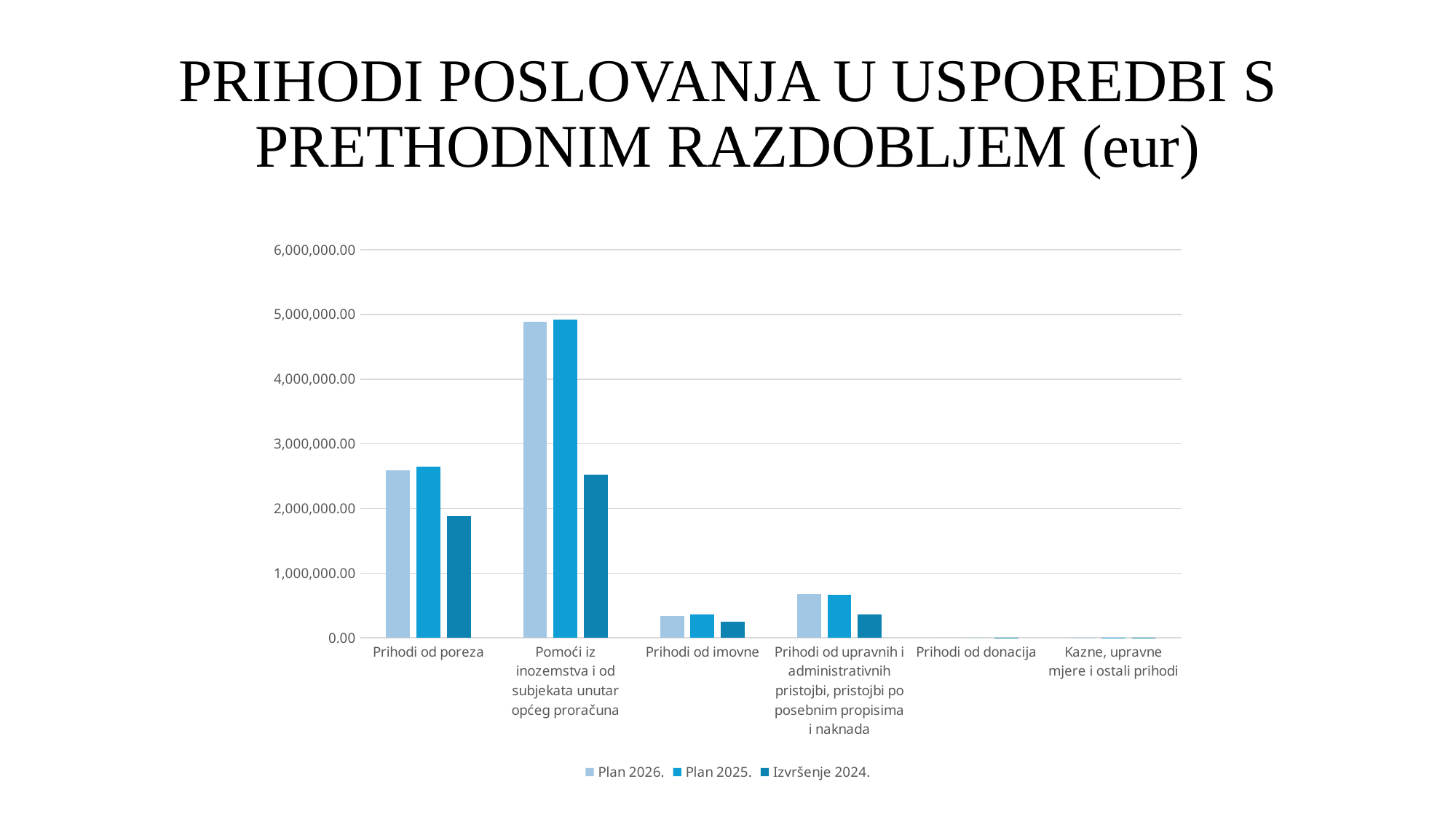
What is the title of the slide? PRIHODI POSLOVANJA U USPOREDBI S PRETHODNIM RAZDOBLJEM (eur) What are the three series listed in the legend? Plan 2026., Plan 2025., Izvršenje 2024. How many series does the legend list? 3 How many categories are shown on the x axis? 6 Is the Plan 2026. value for Pomoći iz inozemstva i od subjekata unutar općeg proračuna greater or less than 4,000,000.00? greater Is the Plan 2025. value for Prihodi od upravnih i administrativnih pristojbi, pristojbi po posebnim propisima i naknada greater or less than 1,000,000.00? less What kind of chart is shown on the slide? Bar chart For Prihodi od poreza, which is larger: Plan 2026. or Izvršenje 2024.? Plan 2026. For Izvršenje 2024., which is larger: Prihodi od poreza or Pomoći iz inozemstva i od subjekata unutar općeg proračuna? Pomoći iz inozemstva i od subjekata unutar općeg proračuna Which category has the highest value for Plan 2025.? Pomoći iz inozemstva i od subjekata unutar općeg proračuna Is the Izvršenje 2024. value for Prihodi od poreza greater or less than 2,000,000.00? less